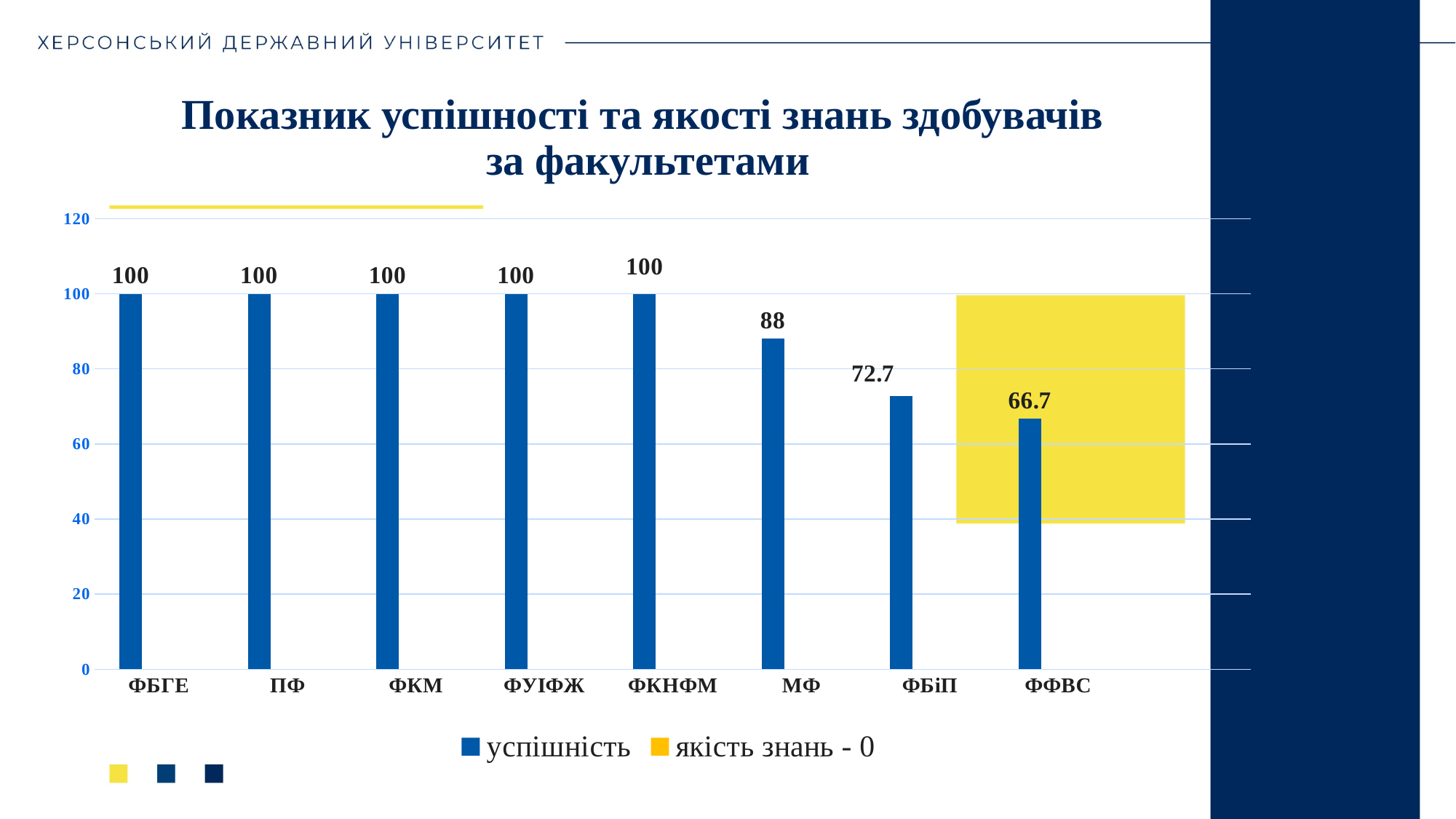
Which is larger, the успішність value for МФ or for ФБіП? МФ How many faculties have an успішність value of 100? 5 Which faculty has the lowest успішність value? ФФВС What is the успішність value for ФКНФМ? 100 What is the успішність value for ФБіП? 72.7 What is the difference between the успішність values for ФБіП and ФФВС? 6 What is the успішність value for МФ? 88 What is the difference between the успішність values for МФ and ФФВС? 21.3 How many series does the legend list? 2 What is the успішність value for ФФВС? 66.7 How many faculties are shown on the x axis? 8 What kind of chart is shown on the slide? bar chart